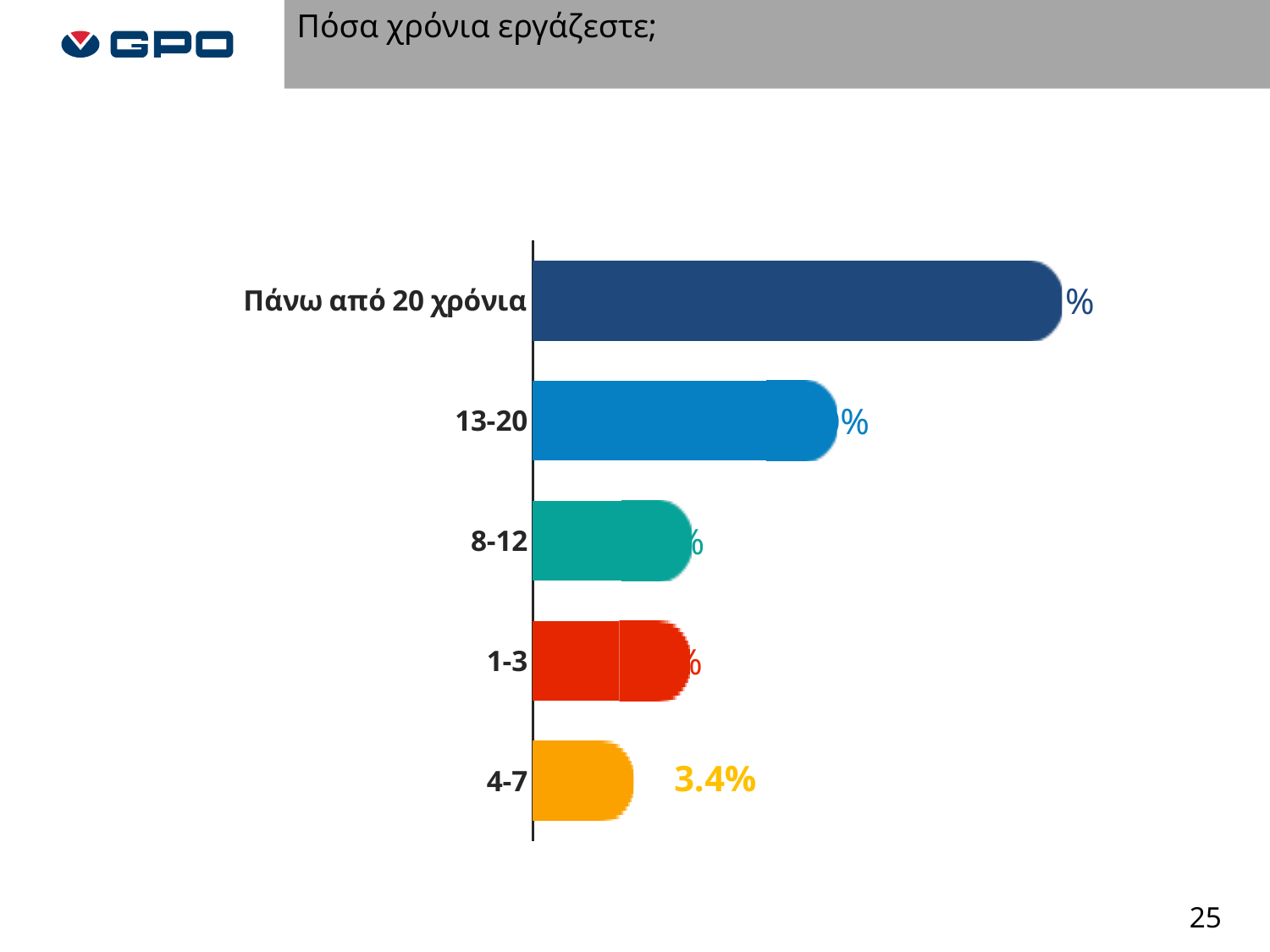
What is the value for the 4-7 category? 3.4% Which category has the lowest value? 4-7 How many categories are shown in the chart? 5 Which is larger, the value for Πάνω από 20 χρόνια or the value for 13-20? Πάνω από 20 χρόνια What kind of chart is shown on the slide? Bar chart What colour is the bar for the 4-7 category? Orange What is the title of the slide? Πόσα χρόνια εργάζεστε; Which is larger, the value for 13-20 or the value for 8-12? 13-20 Which is larger, the value for 1-3 or the value for 4-7? 1-3 Which category has the highest value? Πάνω από 20 χρόνια